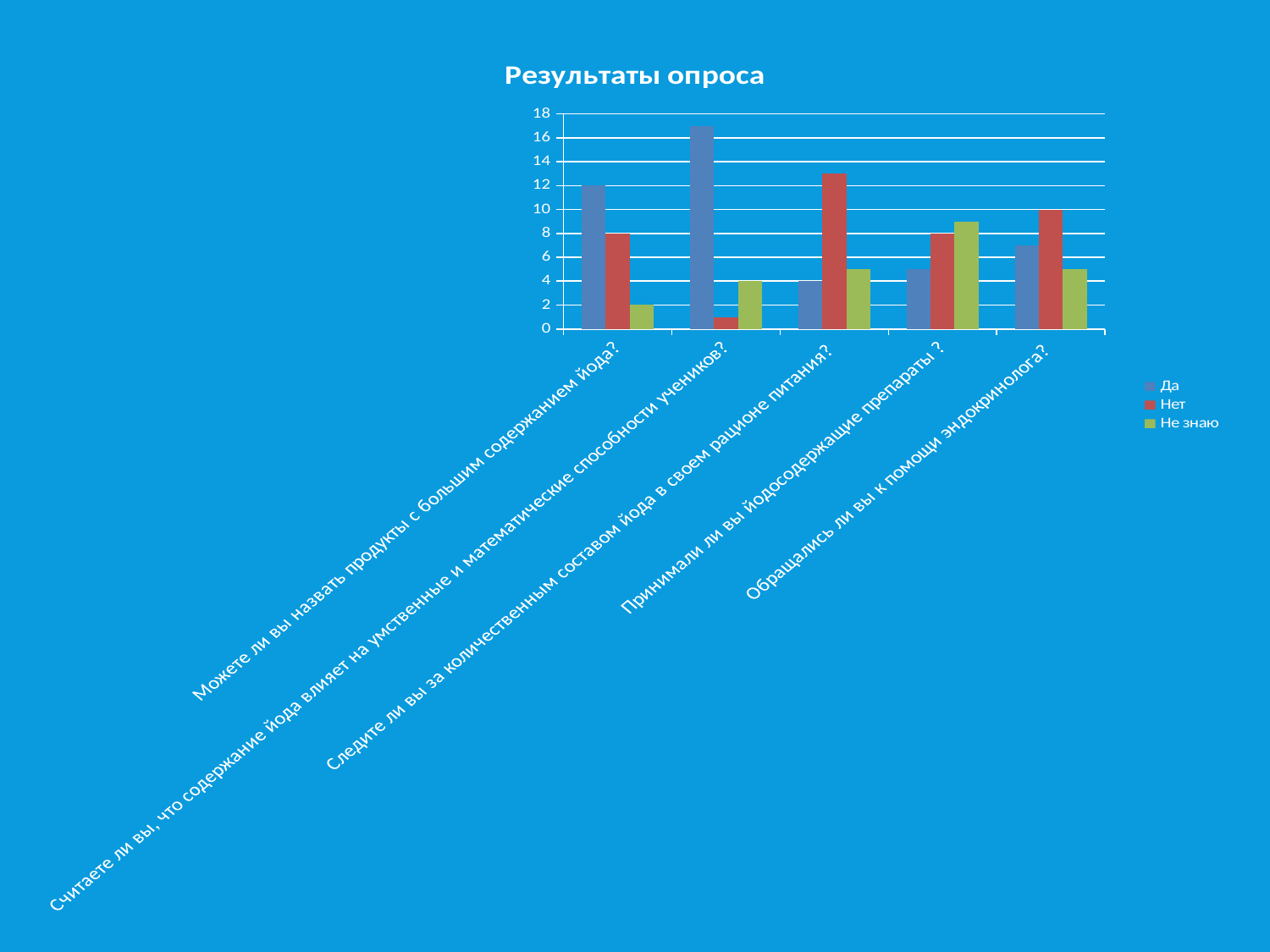
For "Принимали ли вы йодосодержащие препараты ?", which is larger: "Да" or "Не знаю"? Не знаю What is the value of "Да" for "Можете ли вы назвать продукты с большим содержанием йода?"? 12 What kind of chart is shown on the slide? bar chart What is the value of "Не знаю" for "Можете ли вы назвать продукты с большим содержанием йода?"? 2 What is the value of "Нет" for "Можете ли вы назвать продукты с большим содержанием йода?"? 8 Is the "Да" value for "Считаете ли вы, что содержание йода влияет на умственные и математические способности учеников?" greater or less than 16? greater How many question categories are shown on the x axis? 5 Which category has the highest "Да" value? Считаете ли вы, что содержание йода влияет на умственные и математические способности учеников? Is the "Нет" value for "Следите ли вы за количественным составом йода в своем рационе питания?" greater or less than 12? greater What is the title of the chart? Результаты опроса What is the value of "Нет" for "Обращались ли вы к помощи эндокринолога?"? 10 How many series does the legend list? 3